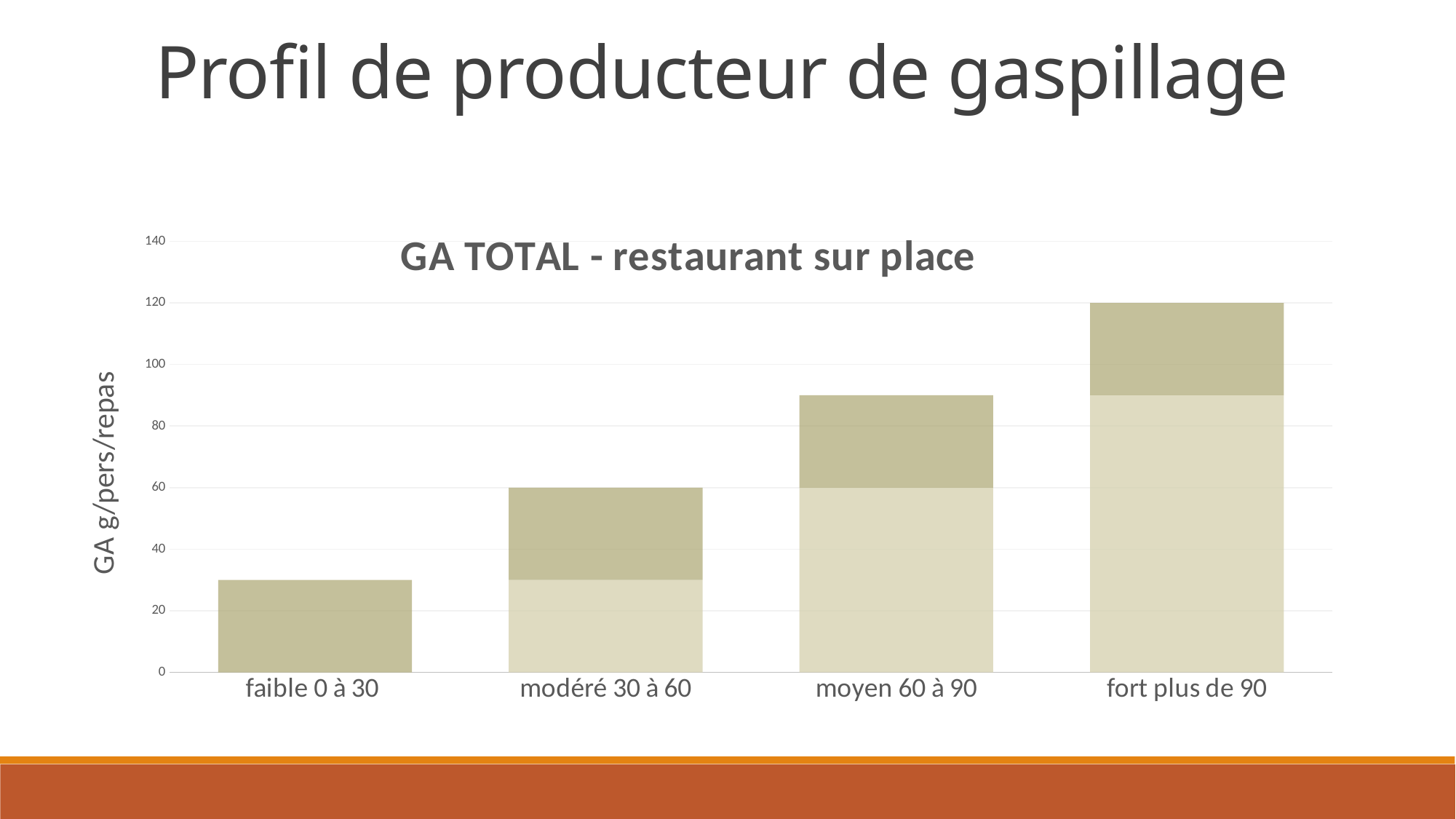
Do the bar totals rise or fall from left to right along the x axis? rise What kind of chart is shown on the slide? bar chart What is the total height of the bar for 'fort plus de 90'? 120 What is the title of the chart? GA TOTAL - restaurant sur place Which category has the lowest total bar? faible 0 à 30 Which has the larger total bar, 'moyen 60 à 90' or 'modéré 30 à 60'? moyen 60 à 90 Is the total value for 'modéré 30 à 60' greater or less than 80? less Which category has the highest total bar? fort plus de 90 Is the total value for 'fort plus de 90' greater or less than 100? greater How many categories are shown on the x axis of the chart? 4